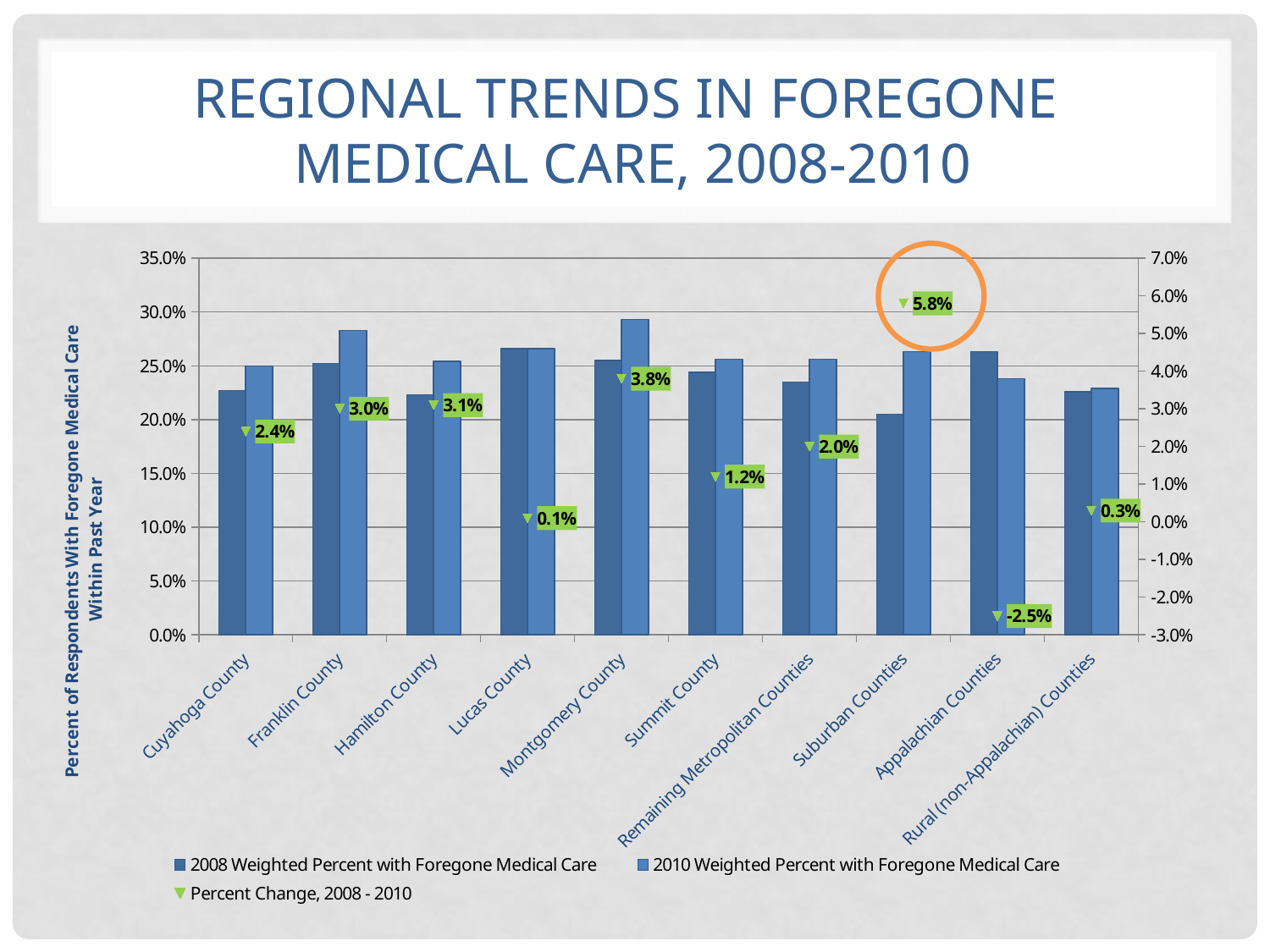
Which category has the lowest Percent Change, 2008 - 2010? Appalachian Counties Which category is highlighted with an orange circle on the chart? Suburban Counties Which category has the highest Percent Change, 2008 - 2010? Suburban Counties How many categories are shown on the x axis? 10 How many series does the legend list? 3 Which has a larger Percent Change, 2008 - 2010: Montgomery County or Hamilton County? Montgomery County Is the 2008 Weighted Percent with Foregone Medical Care for Cuyahoga County greater or less than 25.0%? less What is the Percent Change, 2008 - 2010 for Lucas County? 0.1% What is the difference between the Percent Change for Suburban Counties and Appalachian Counties? 8.3% What is the Percent Change, 2008 - 2010 for Appalachian Counties? -2.5% Is the 2010 Weighted Percent with Foregone Medical Care for Montgomery County greater or less than 25.0%? greater What is the Percent Change, 2008 - 2010 for Suburban Counties? 5.8%